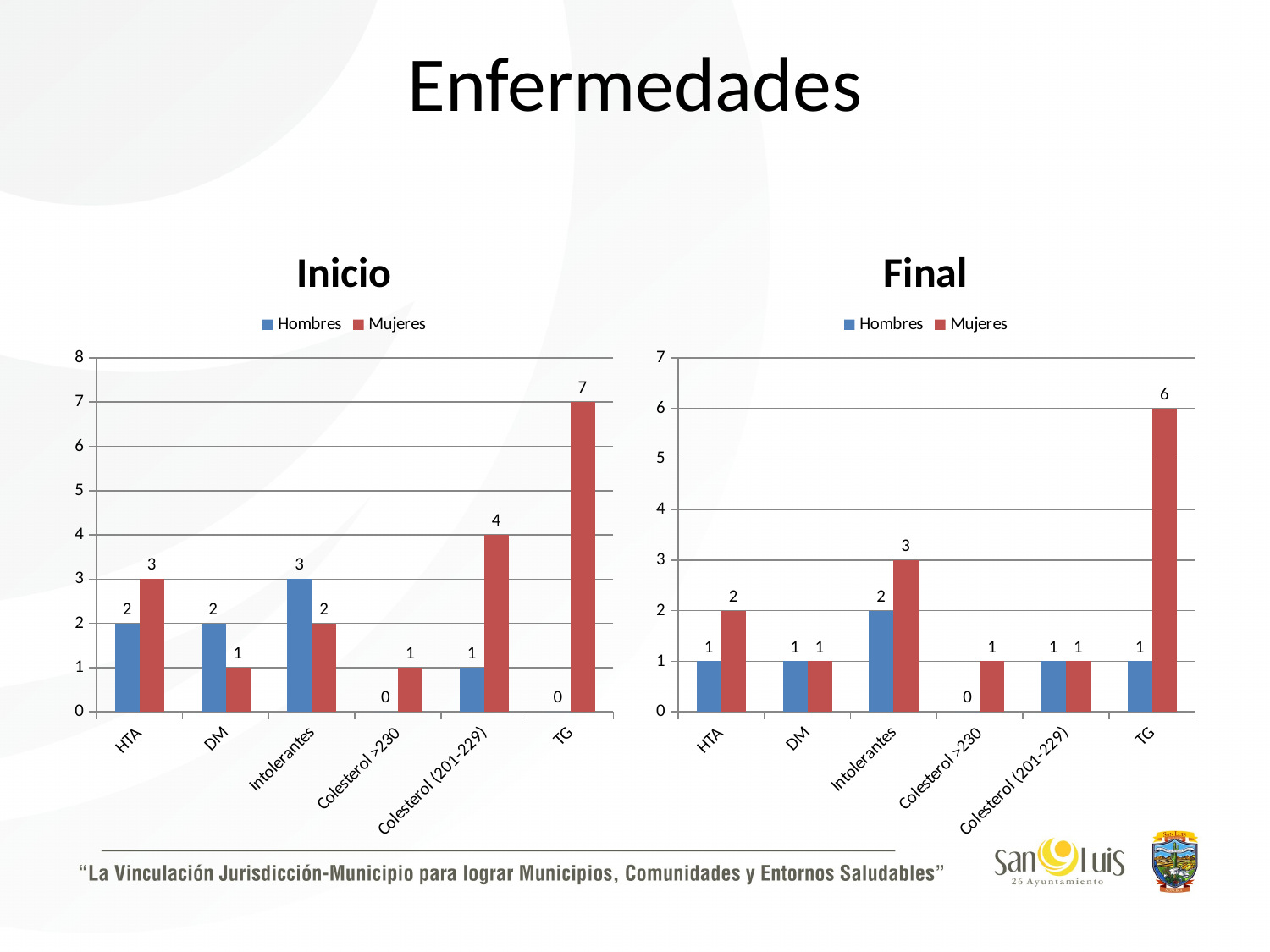
What type of chart is the Inicio chart? Bar chart In the Final chart, what is the value for Hombres in the Colesterol >230 category? 0 In the Inicio chart, what is the difference between the Mujeres and Hombres values for Colesterol (201-229)? 3 In the Final chart, what is the value for Mujeres in the TG category? 6 In the Final chart, what is the value for Hombres in the Intolerantes category? 2 In the Inicio chart, which category has the highest Mujeres value? TG In the Final chart, which is larger for HTA, the Hombres value or the Mujeres value? Mujeres How many categories are shown on the x axis of the Inicio chart? 6 How many series does the legend of the Final chart list? 2 In the Final chart, which category has the highest Hombres value? Intolerantes In the Inicio chart, what is the value for Hombres in the Intolerantes category? 3 In the Inicio chart, what is the value for Mujeres in the TG category? 7